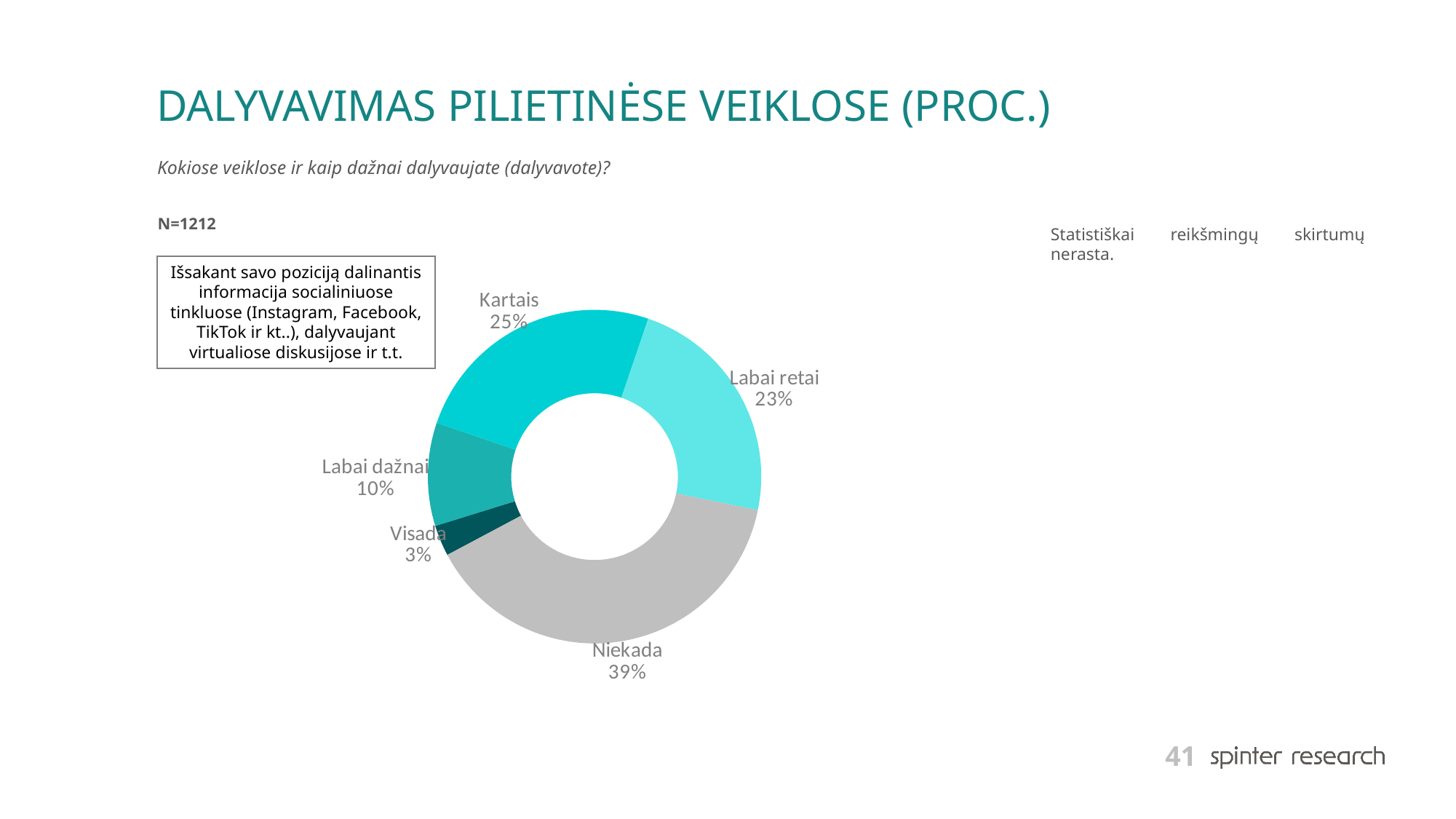
What is the difference between the "Niekada" and "Kartais" values in the pie chart? 14% What kind of chart is shown on the slide? Doughnut chart Which category has the largest slice in the pie chart? Niekada Which is larger in the pie chart, "Labai dažnai" or "Labai retai"? Labai retai What sample size (N) is stated on the slide? N=1212 Which category has the smallest slice in the pie chart? Visada What share of the pie chart does the "Niekada" slice represent? 39% What is the difference between the "Labai dažnai" and "Visada" values in the pie chart? 7% What is the value shown for "Labai retai" in the pie chart? 23% How many categories are shown in the pie chart? 5 What is the value shown for "Kartais" in the pie chart? 25% What is the value shown for "Visada" in the pie chart? 3%